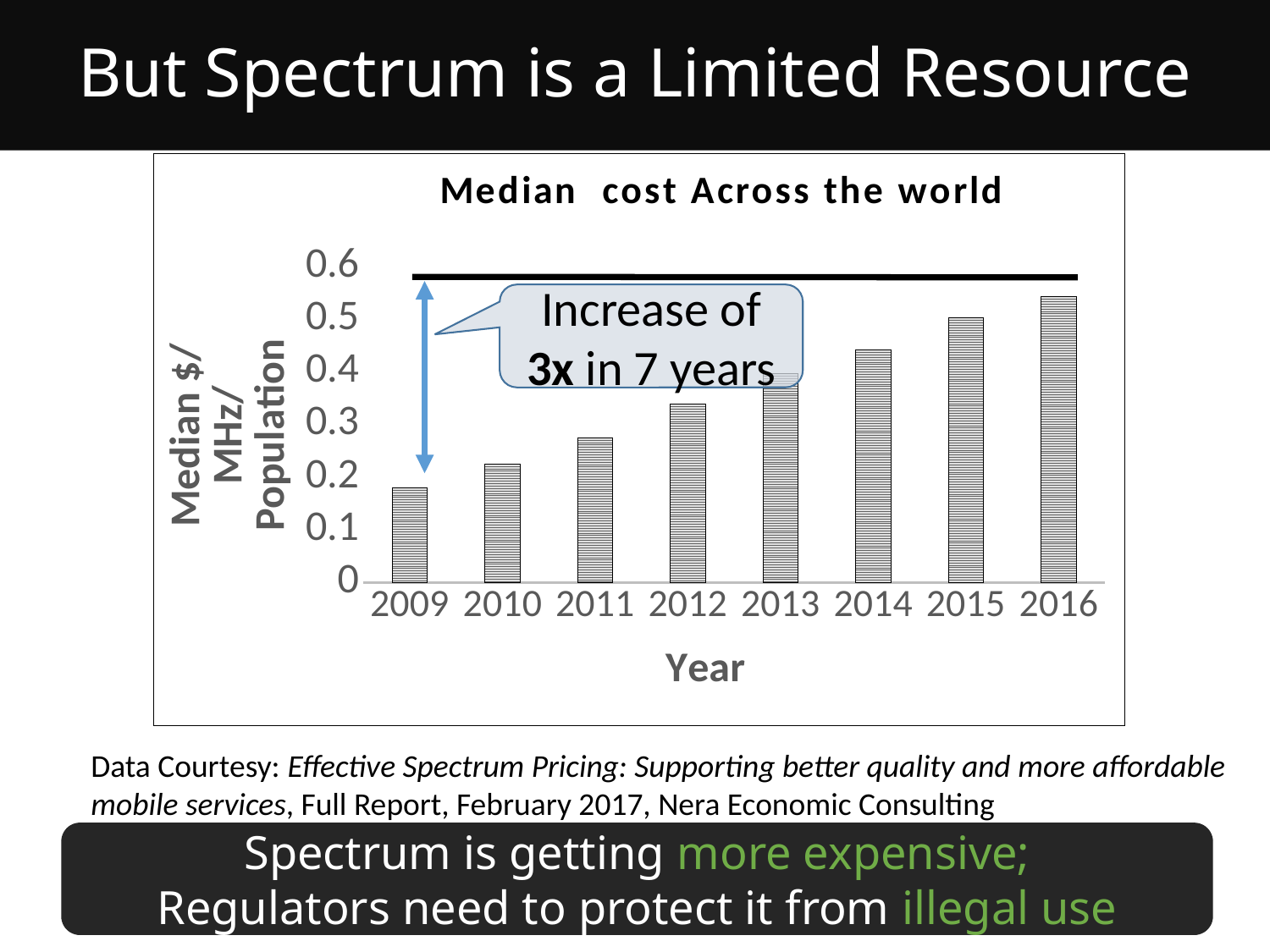
Which year has the highest median cost in the chart? 2016 Which year has the lowest median cost in the chart? 2009 What is the title of the chart? Median cost Across the world How many years are plotted on the x axis of the chart? 8 What is the label on the x axis of the chart? Year Which year has a larger median cost, 2011 or 2014? 2014 Is the value for 2014 greater or less than 0.4? greater Is the value for 2009 greater or less than 0.2? less Do the values in the chart rise or fall from 2009 to 2016? rise Is the value for 2016 greater or less than 0.5? greater What kind of chart is shown on the slide? bar chart